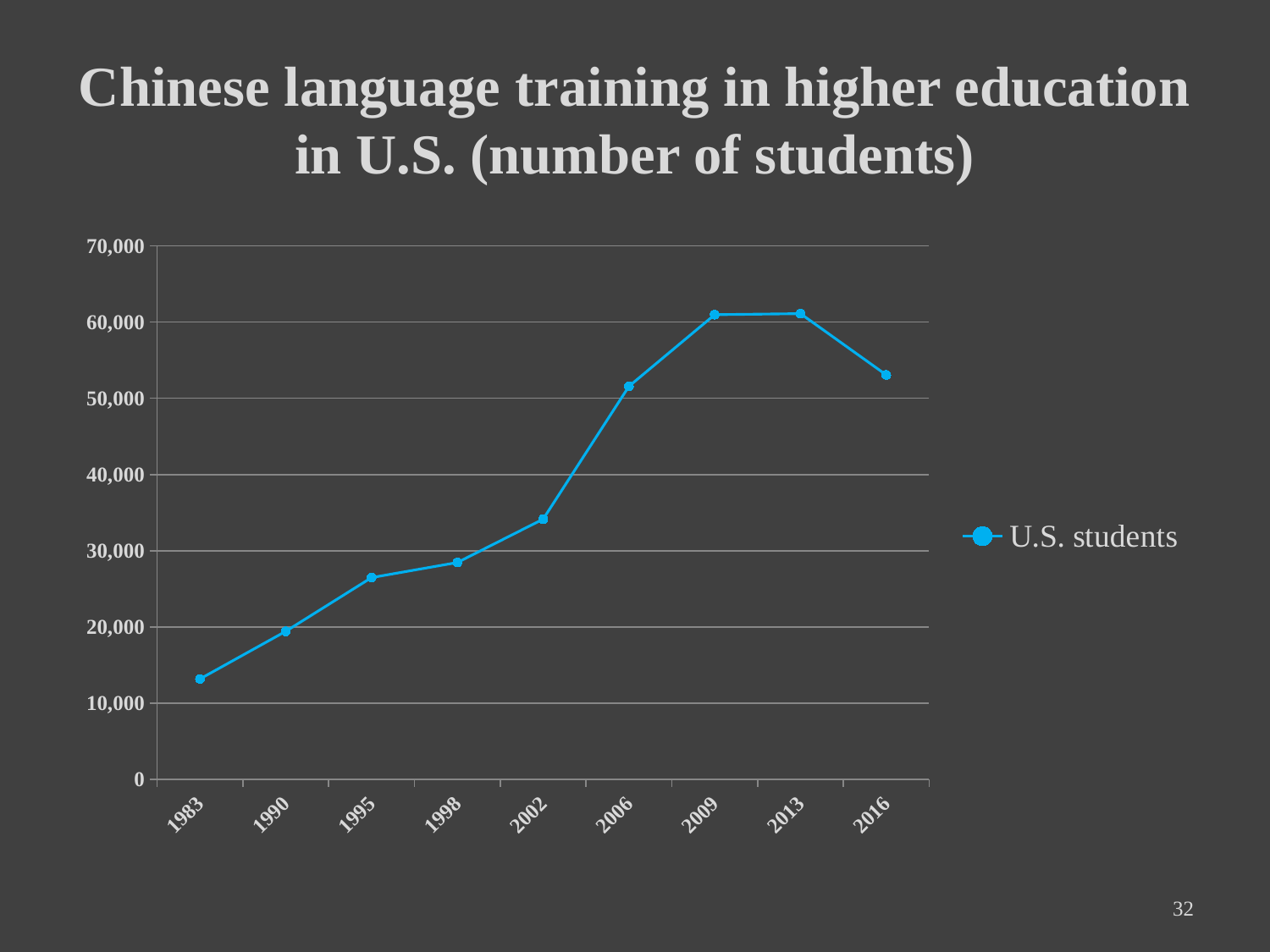
Does the number of U.S. students rise or fall between 1983 and 2009? rise Is the value for 2016 greater or less than 60,000? less What is the name of the series shown in the legend? U.S. students Is the value for 2009 greater or less than 50,000? greater How many data points are plotted on the chart? 9 Which year has a higher value, 2013 or 2016? 2013 Is the value for 1983 greater or less than 10,000? greater How many series does the legend list? 1 Which year has the lowest number of U.S. students? 1983 Which year has a higher value, 2002 or 2006? 2006 What kind of chart is shown on the slide? line chart